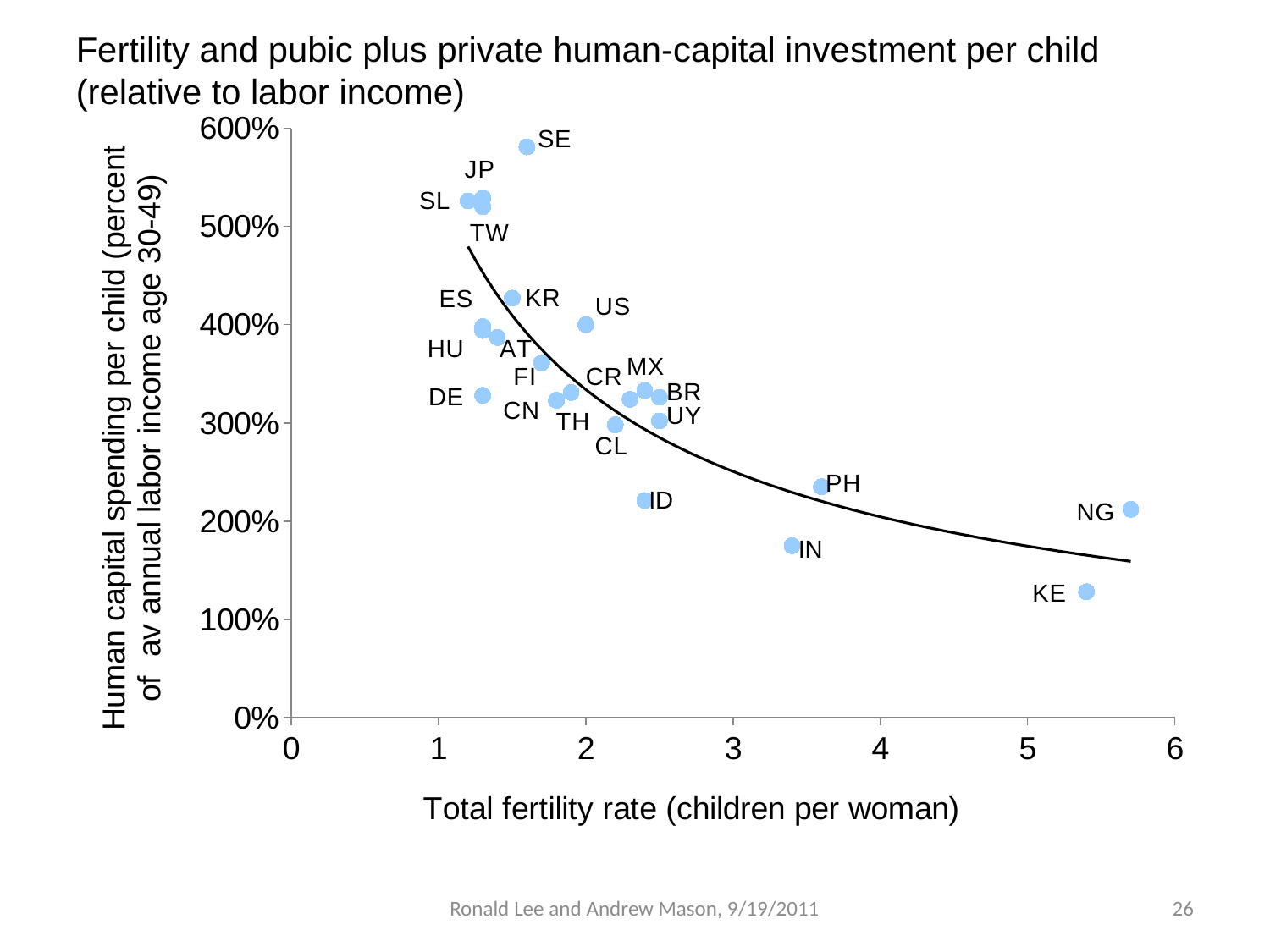
Which country has the lowest human capital spending per child? KE Which country has the highest total fertility rate? NG Is the human capital spending per child for SE greater or less than 500%? greater As the total fertility rate increases, does human capital spending per child generally rise or fall? fall What is the title of the x axis? Total fertility rate (children per woman) Which country has the highest human capital spending per child? SE Is the human capital spending per child for US greater or less than 300%? greater Which has higher human capital spending per child, US or IN? US Is the human capital spending per child for KE greater or less than 200%? less What kind of chart is shown on the slide? scatter chart